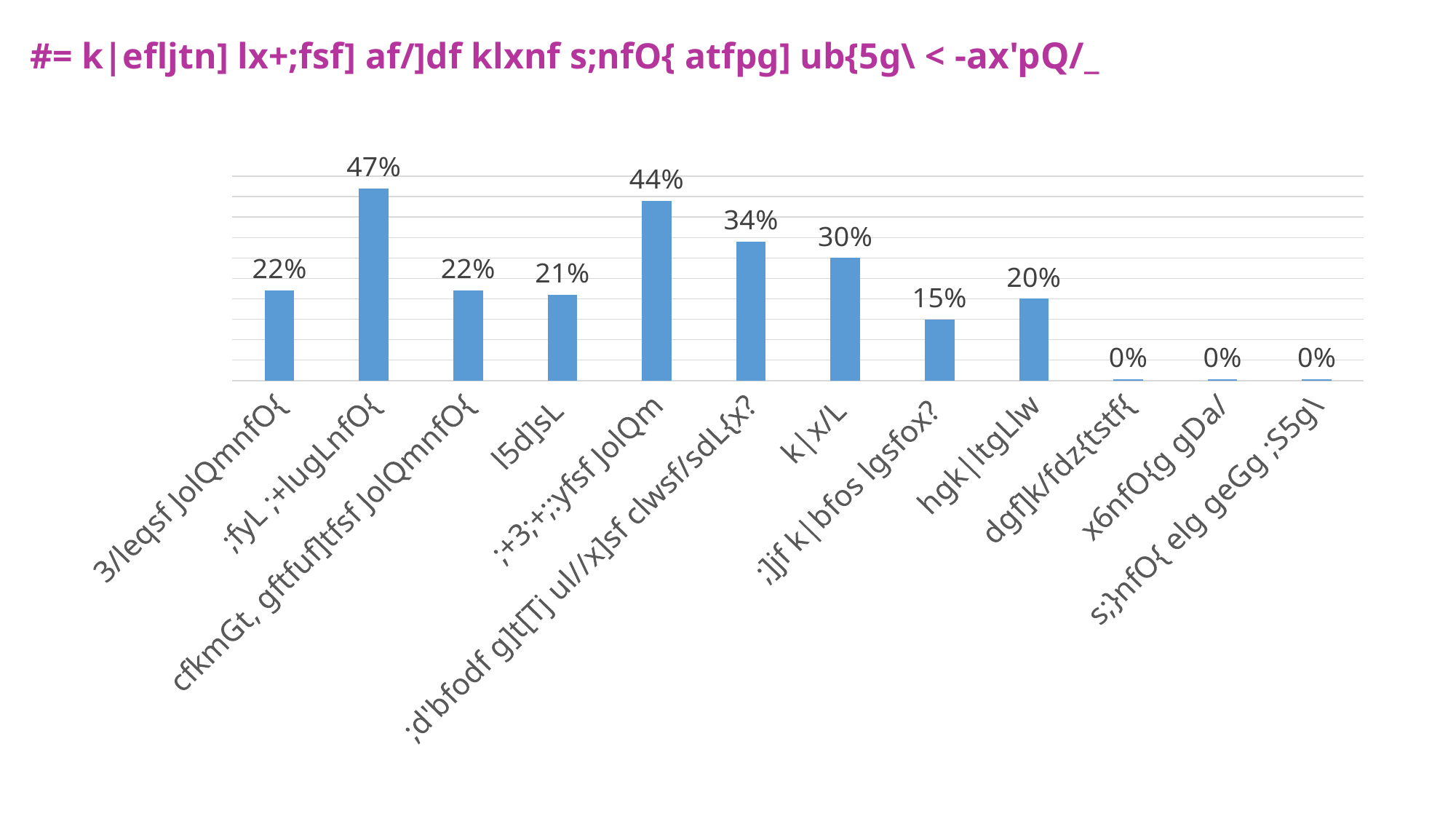
What is the value of the bar labelled 'k|x/L'? 30% What is the value of the second bar from the left (labelled ';fyL ;+lugLnfO{')? 47% What is the value of the bar labelled ':]jf k|bfos lgsfox?'? 15% What kind of chart is shown on the slide? bar chart What is the difference between the highest bar (47%) and the fifth bar from the left (44%)? 3% What is the value of the fifth bar from the left (labelled ';+3;+;:yfsf JolQm')? 44% What is the value of the bar labelled 'hgk|ltgLlw'? 20% How many categories (bars) are plotted on the chart? 12 What is the value of the bar labelled 'l5d]sL'? 21% Which bar has the highest value on the chart? ;fyL ;+lugLnfO{ (second bar from the left, 47%) Which is larger: the value for 'k|x/L' or the value for 'hgk|ltgLlw'? k|x/L How many bars on the chart show a value of 0%? 3